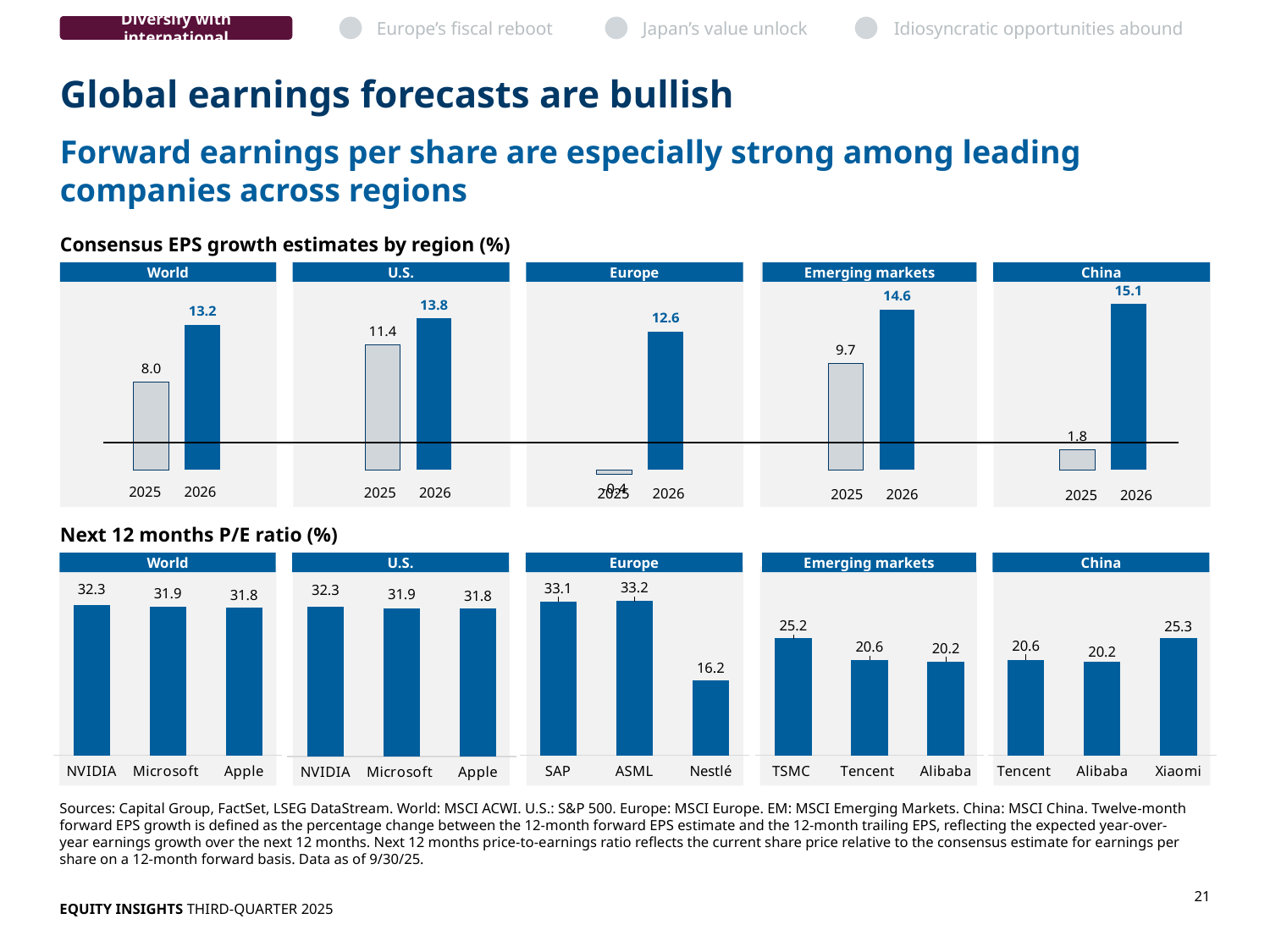
In the Consensus EPS growth estimates by region chart, do the values rise or fall from 2025 to 2026 in the Emerging markets panel? rise In the Next 12 months P/E ratio chart, what is the difference between the values for TSMC and Alibaba in the Emerging markets panel? 5.0 In the Consensus EPS growth estimates by region chart, what is the 2026 value for the World panel? 13.2 In the Next 12 months P/E ratio chart, what is the value for TSMC in the Emerging markets panel? 25.2 In the Consensus EPS growth estimates by region chart, is the 2025 value for Emerging markets larger or smaller than the 2025 value for the U.S.? smaller In the Consensus EPS growth estimates by region chart, which region panel has the highest 2026 value? China In the Next 12 months P/E ratio chart, which company has the highest value in the China panel? Xiaomi In the Consensus EPS growth estimates by region chart, what is the difference between the 2026 and 2025 values in the China panel? 13.3 In the Next 12 months P/E ratio chart, which company has the lowest value in the Europe panel? Nestlé In the Next 12 months P/E ratio chart, what is the value for Nestlé in the Europe panel? 16.2 In the Consensus EPS growth estimates by region chart, what is the 2025 value for the U.S. panel? 11.4 How many companies are shown in the World panel of the Next 12 months P/E ratio chart? 3